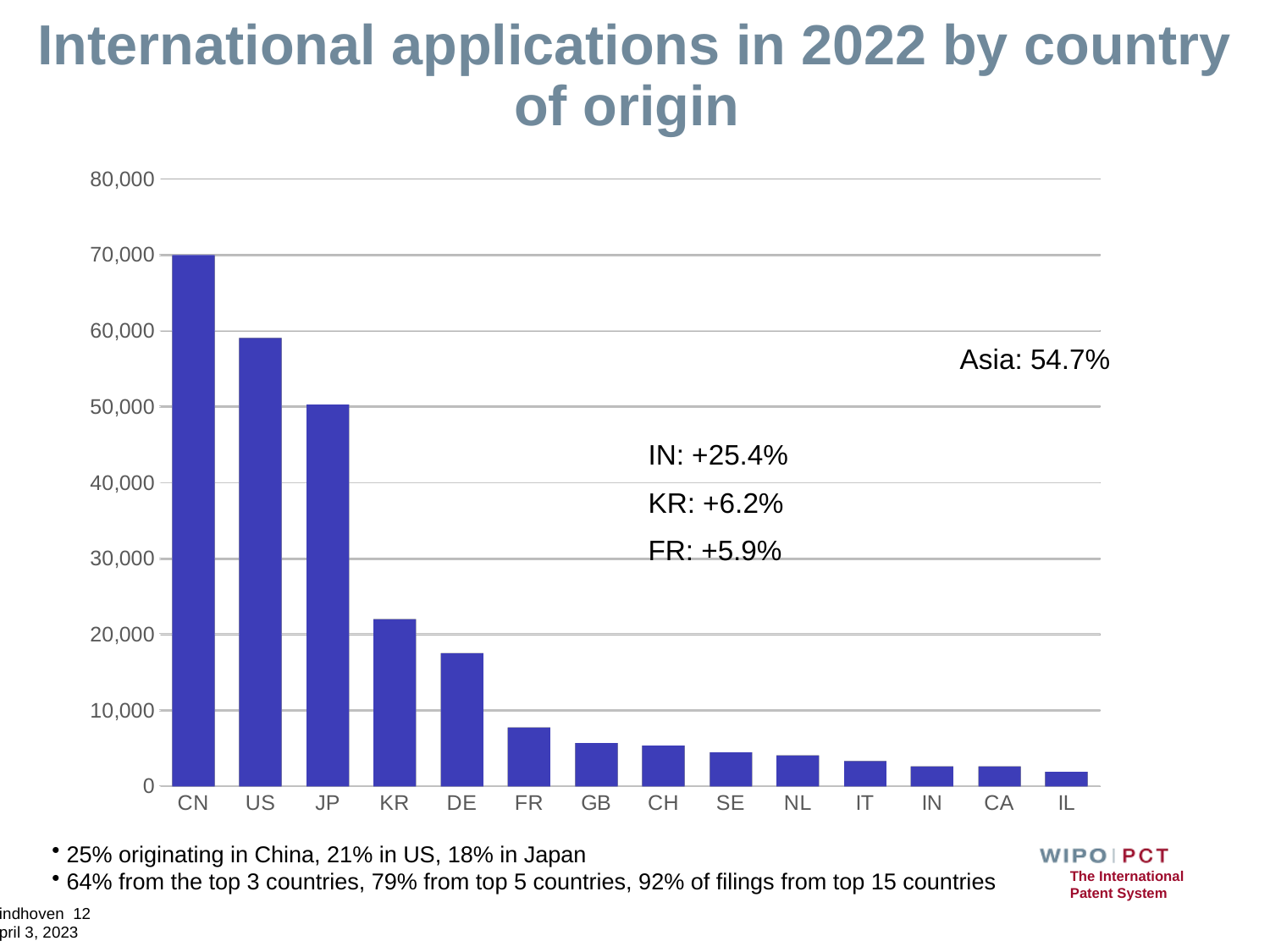
Is the value for US greater or less than 50,000? greater What kind of chart is shown on the slide? bar chart How many countries are shown on the x axis of the chart? 14 Which has the larger value, KR or DE? KR Do the bar values rise or fall from left to right along the x axis? fall Is the value for DE greater or less than 20,000? less What share of international applications does the annotation on the chart attribute to Asia? 54.7% Which country has the highest number of international applications in the chart? CN Is the value for JP greater or less than 60,000? less Which country has the lowest number of international applications in the chart? IL Which has the larger value, US or JP? US